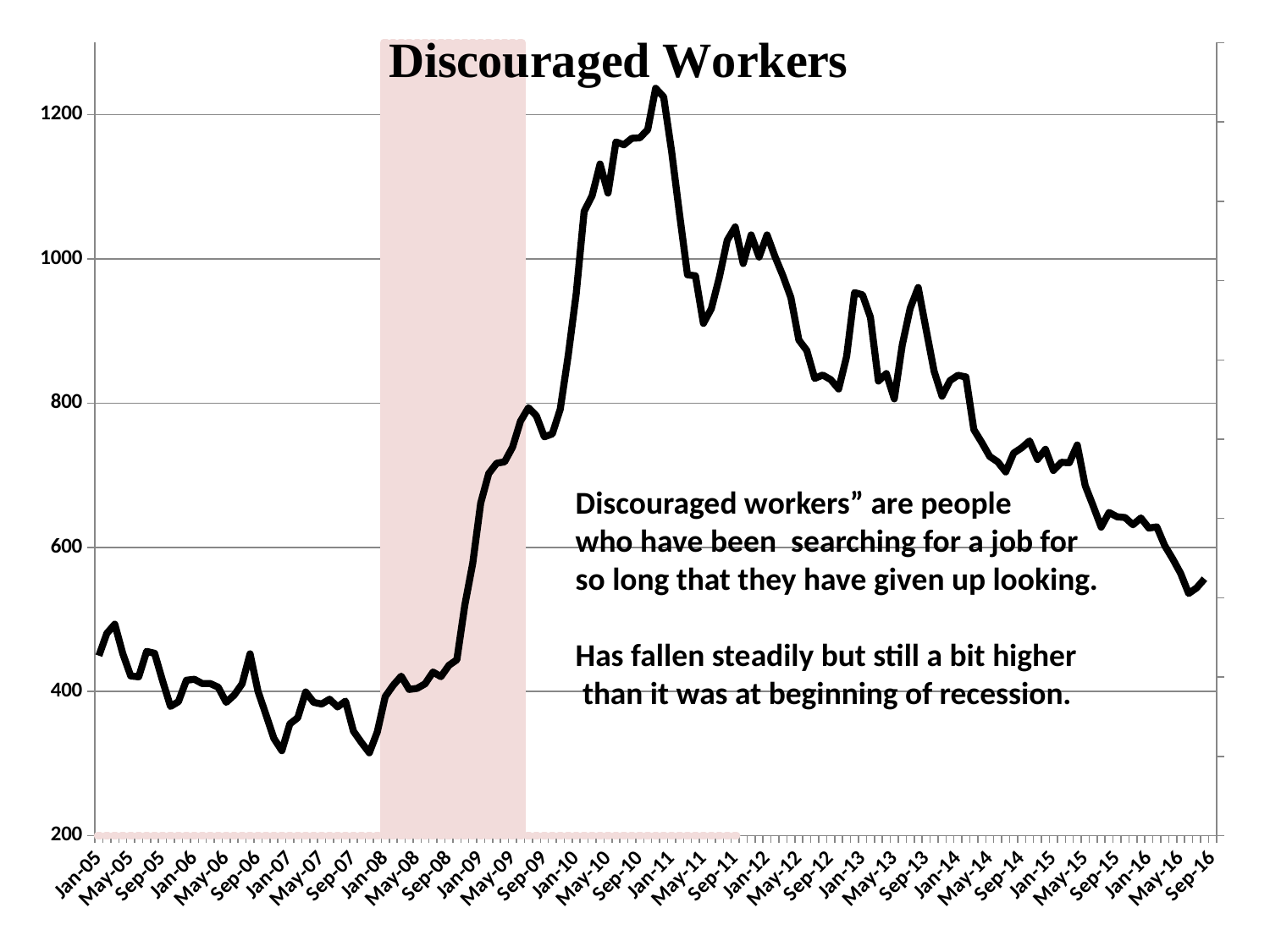
Do the values generally rise or fall between Jan-11 and Sep-16? fall Is the value for Jan-05 greater or less than 400? greater Is the value for Sep-16 greater or less than 600? less Is the value for Jan-10 greater or less than 1000? less Do the values generally rise or fall between Jan-08 and Jan-10? rise How many data series (lines) are plotted on the chart? 1 Which is larger, the value for Jan-11 or the value for Jan-05? Jan-11 What is the title of the chart? Discouraged Workers What kind of chart is shown on the slide? line chart